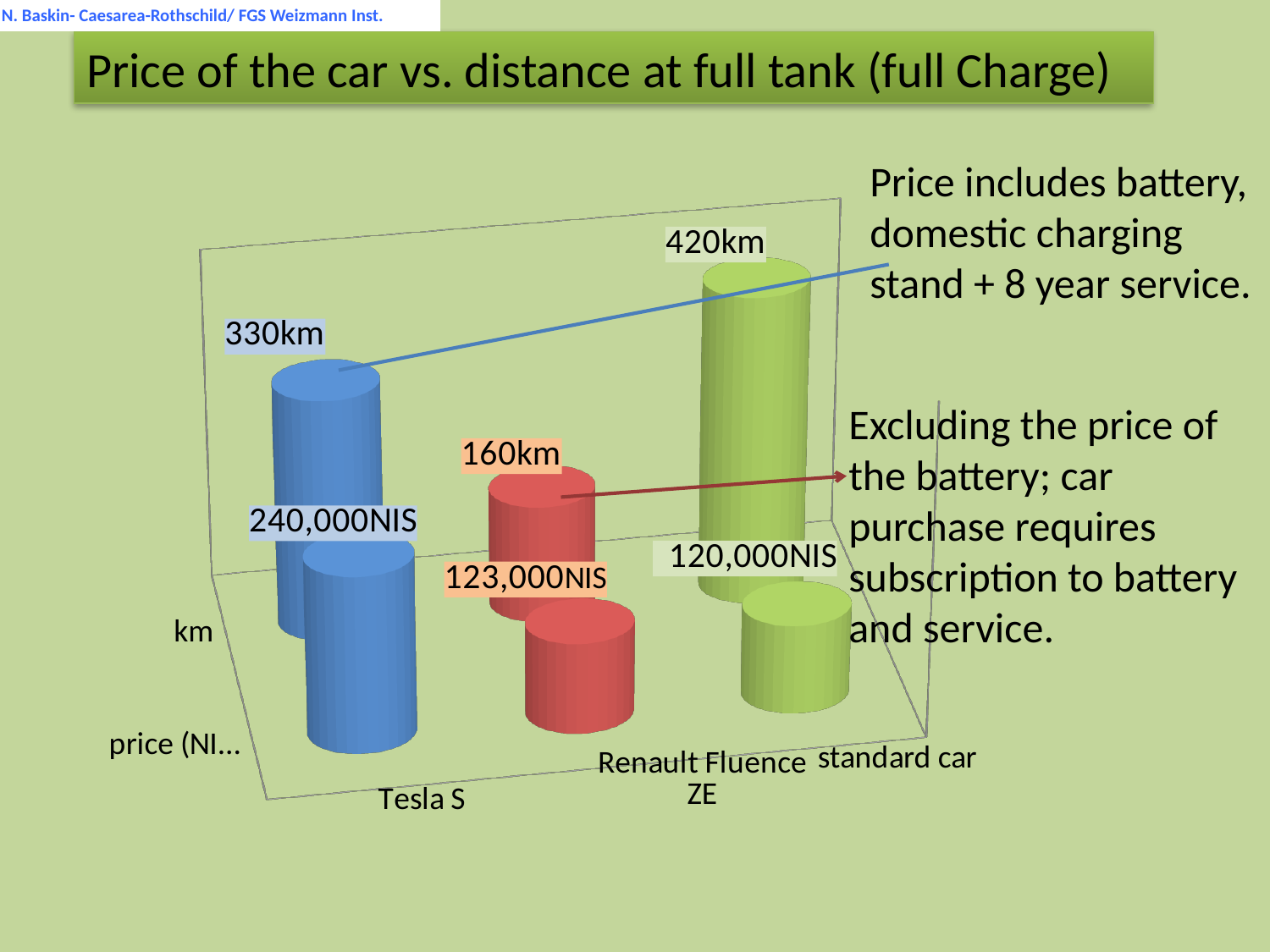
Which car has the lowest price? standard car How many cars are compared in the chart? 3 Which has the greater distance at full charge, the Tesla S or the Renault Fluence ZE? Tesla S What distance at full tank is shown for the standard car? 420km Which car has the shortest distance at full charge? Renault Fluence ZE What is the distance at full tank (full charge) shown for the Tesla S? 330km What is the title of the chart on the slide? Price of the car vs. distance at full tank (full Charge) What is the difference in price between the Tesla S and the Renault Fluence ZE? 117,000NIS How much greater is the distance of the standard car than that of the Tesla S? 90km Which car has the highest distance at full tank (full charge)? standard car What is the price shown for the Tesla S? 240,000NIS What is the price shown for the Renault Fluence ZE? 123,000NIS